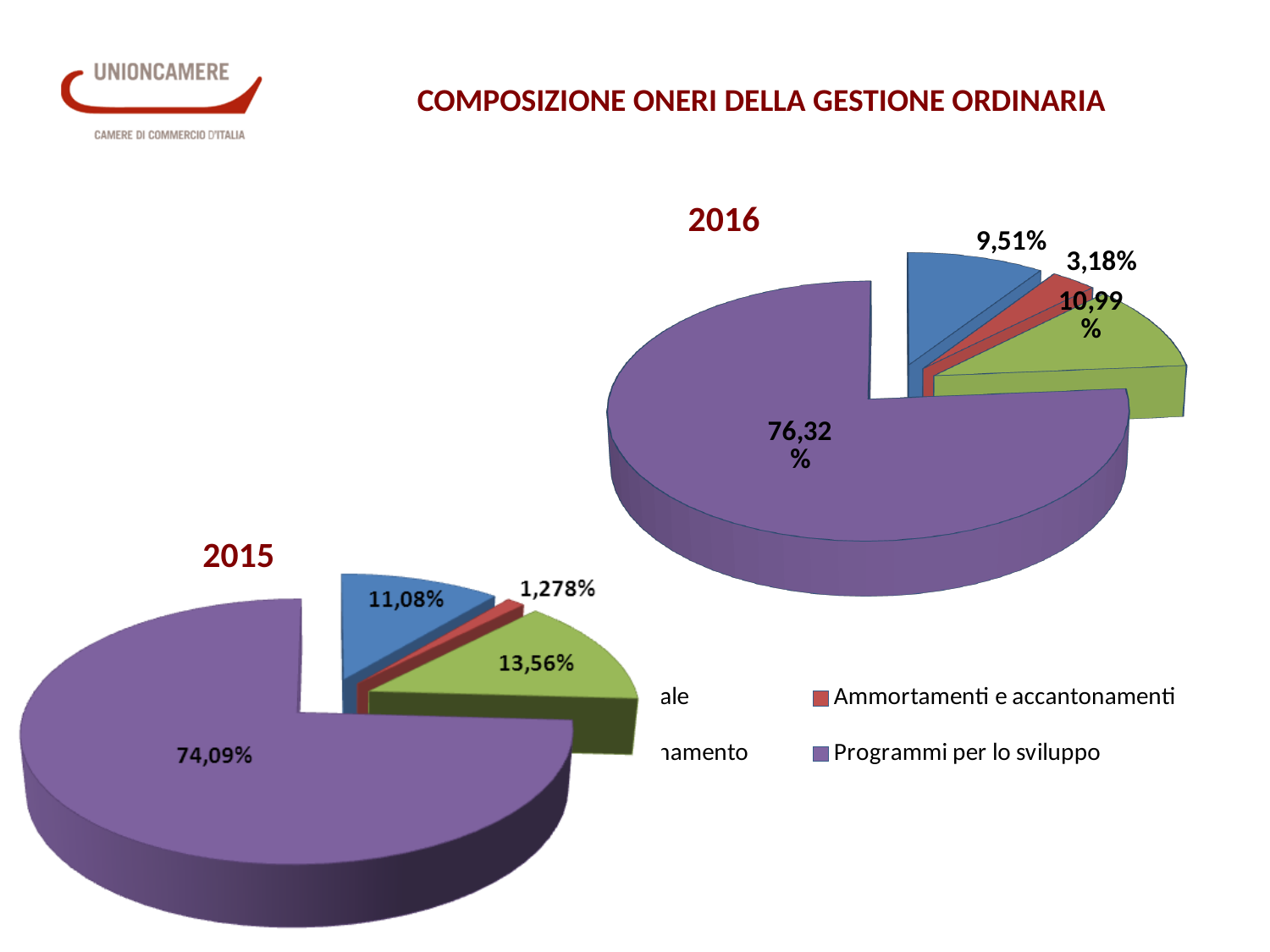
In the 2016 pie chart, which category has the largest slice? Programmi per lo sviluppo What is the difference between the Programmi per lo sviluppo share in the 2016 pie chart and in the 2015 pie chart? 2,23 percentage points In the 2015 pie chart, what share is shown for Ammortamenti e accantonamenti? 1,278% In the 2015 pie chart, what share is shown for Programmi per lo sviluppo? 74,09% What type of chart is used for the 2016 data? Pie chart What is the title of the slide's charts? COMPOSIZIONE ONERI DELLA GESTIONE ORDINARIA In the 2015 pie chart, which category has the smallest slice? Ammortamenti e accantonamenti Is the share of Programmi per lo sviluppo larger in the 2016 pie chart or in the 2015 pie chart? 2016 How many slices does the 2016 pie chart have? 4 In the 2016 pie chart, what share is shown for Programmi per lo sviluppo? 76,32% What colour represents Programmi per lo sviluppo in the pie charts? Purple In the 2016 pie chart, what share is shown for Ammortamenti e accantonamenti? 3,18%